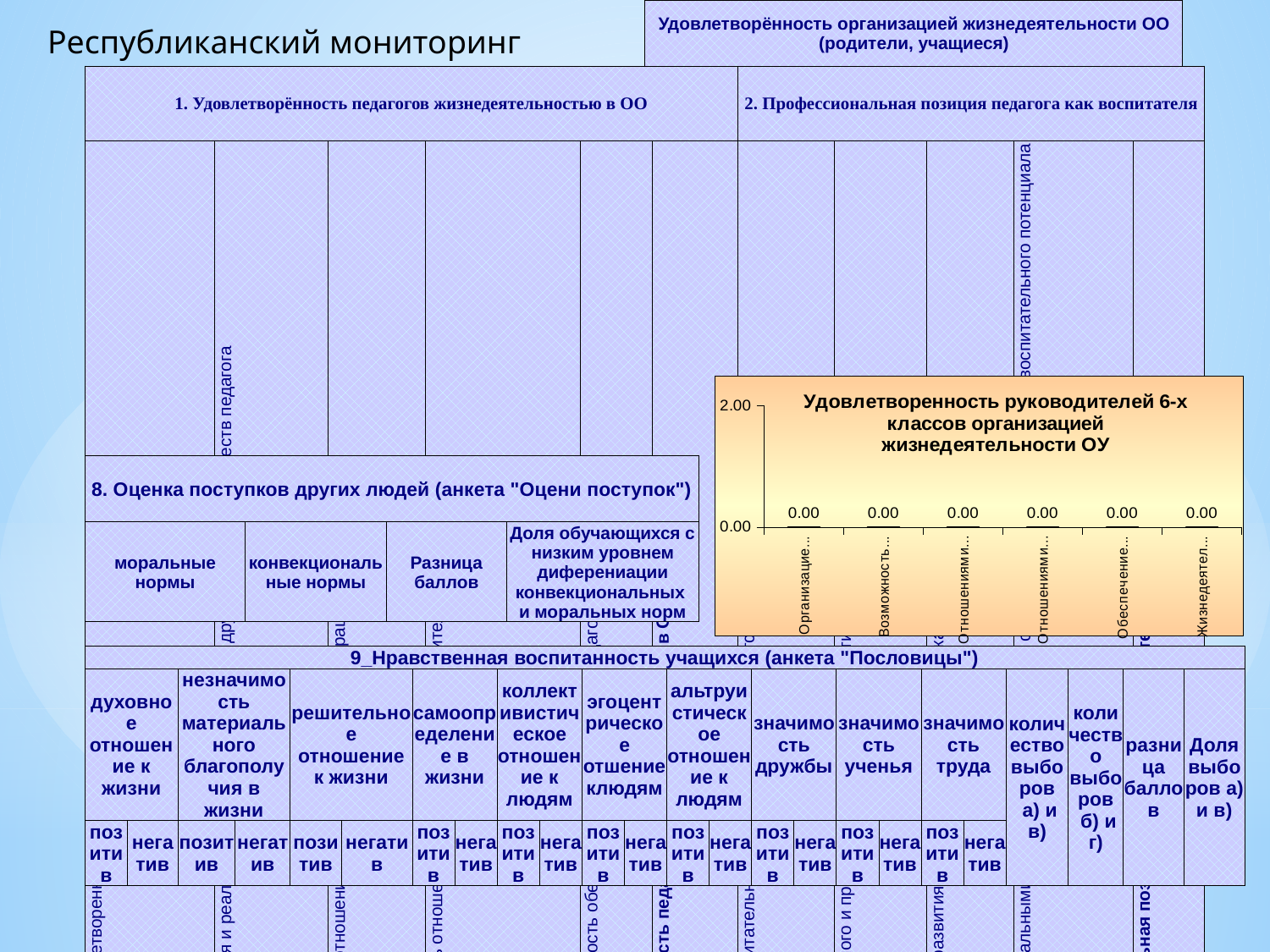
What is the title of the chart on the slide? Удовлетворенность руководителей 6-х классов организацией жизнедеятельности ОУ What is the value shown for the last (rightmost) category in the chart? 0.00 Do the values rise, fall, or stay the same across the categories from left to right? stay the same What is the highest value shown on the vertical axis of the chart? 2.00 What is the difference between the values of the first and the last category in the chart? 0.00 What is the value shown for the third category from the left in the chart? 0.00 How many categories are plotted in the chart? 6 What is the value shown for the first (leftmost) category in the chart? 0.00 Is the value for the second category from the left greater or less than 2.00? less What kind of chart is shown on the slide? bar chart